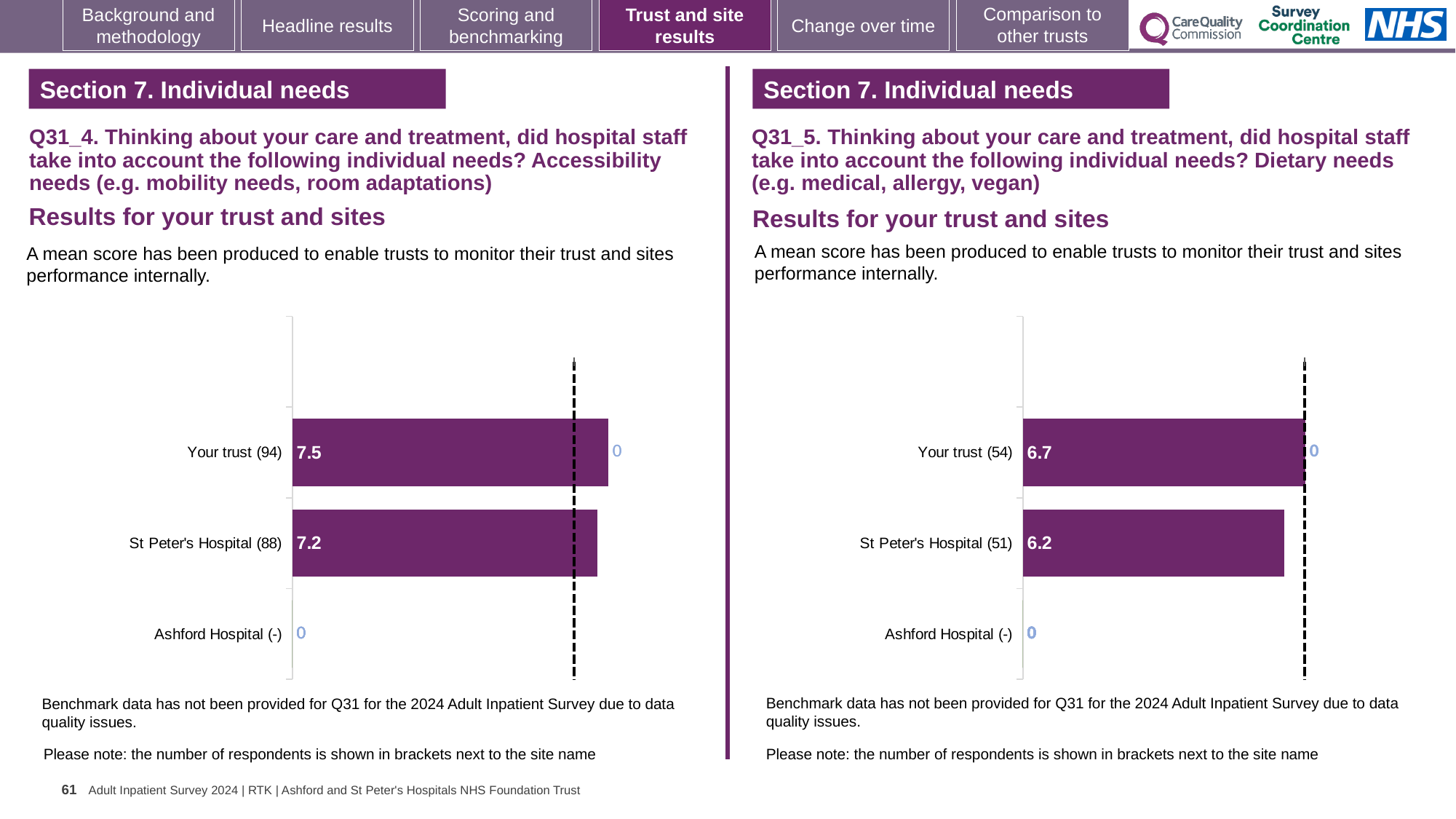
How many categories are listed on the y axis of the left chart (Q31_4, accessibility needs)? 3 What kind of chart is used on the right side of the slide (Q31_5, dietary needs)? Bar chart On the right chart (Q31_5, dietary needs), what is the mean score for St Peter's Hospital? 6.2 On the right chart (Q31_5, dietary needs), what is the mean score for Your trust? 6.7 On the left chart (Q31_4, accessibility needs), how many respondents are shown in brackets for Your trust? 94 On the right chart (Q31_5, dietary needs), which is larger, the score for Your trust or for St Peter's Hospital? Your trust On the right chart (Q31_5, dietary needs), how many respondents are shown in brackets for St Peter's Hospital? 51 On the right chart (Q31_5, dietary needs), what is the difference between the Your trust score and the St Peter's Hospital score? 0.5 On the left chart (Q31_4, accessibility needs), what is the mean score for Your trust? 7.5 On the left chart (Q31_4, accessibility needs), what is the mean score for St Peter's Hospital? 7.2 Which site on the left chart (Q31_4, accessibility needs) has no score shown, with a dash in brackets? Ashford Hospital On the left chart (Q31_4, accessibility needs), what is the difference between the Your trust score and the St Peter's Hospital score? 0.3